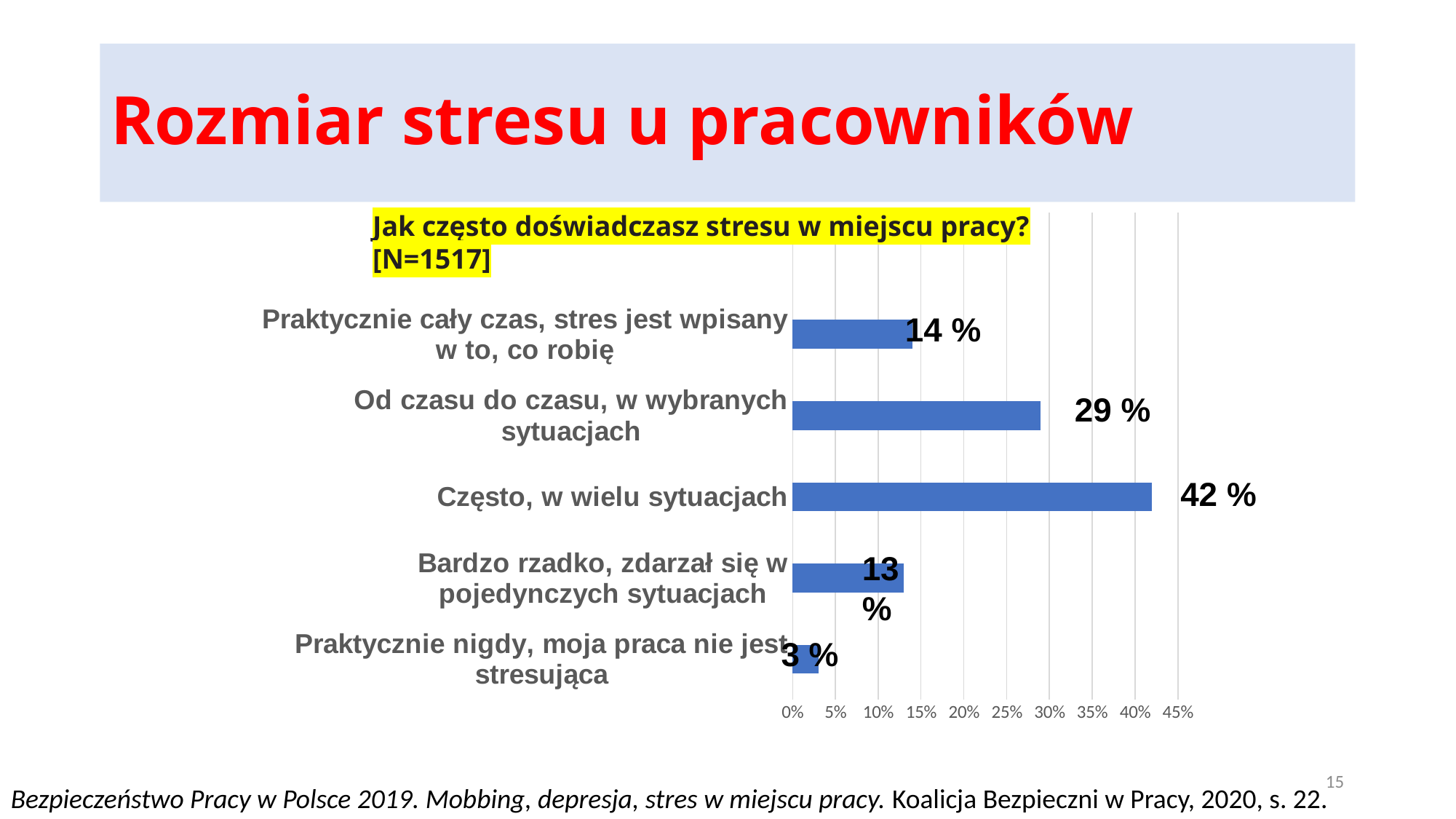
What is the difference between the values for "Często, w wielu sytuacjach" and "Od czasu do czasu, w wybranych sytuacjach"? 13 % What is the value for "Od czasu do czasu, w wybranych sytuacjach"? 29 % What is the value for "Praktycznie cały czas, stres jest wpisany w to, co robię"? 14 % Which is larger: the value for "Praktycznie cały czas, stres jest wpisany w to, co robię" or for "Bardzo rzadko, zdarzał się w pojedynczych sytuacjach"? Praktycznie cały czas, stres jest wpisany w to, co robię Which category has the lowest value? Praktycznie nigdy, moja praca nie jest stresująca What is the value for "Często, w wielu sytuacjach"? 42 % What is the sample size (N) given in the chart title? 1517 How many categories are shown in the chart? 5 Is the value for "Od czasu do czasu, w wybranych sytuacjach" greater or less than 25%? greater What is the value for "Praktycznie nigdy, moja praca nie jest stresująca"? 3 % Which category has the highest value? Często, w wielu sytuacjach What kind of chart is shown on the slide? bar chart